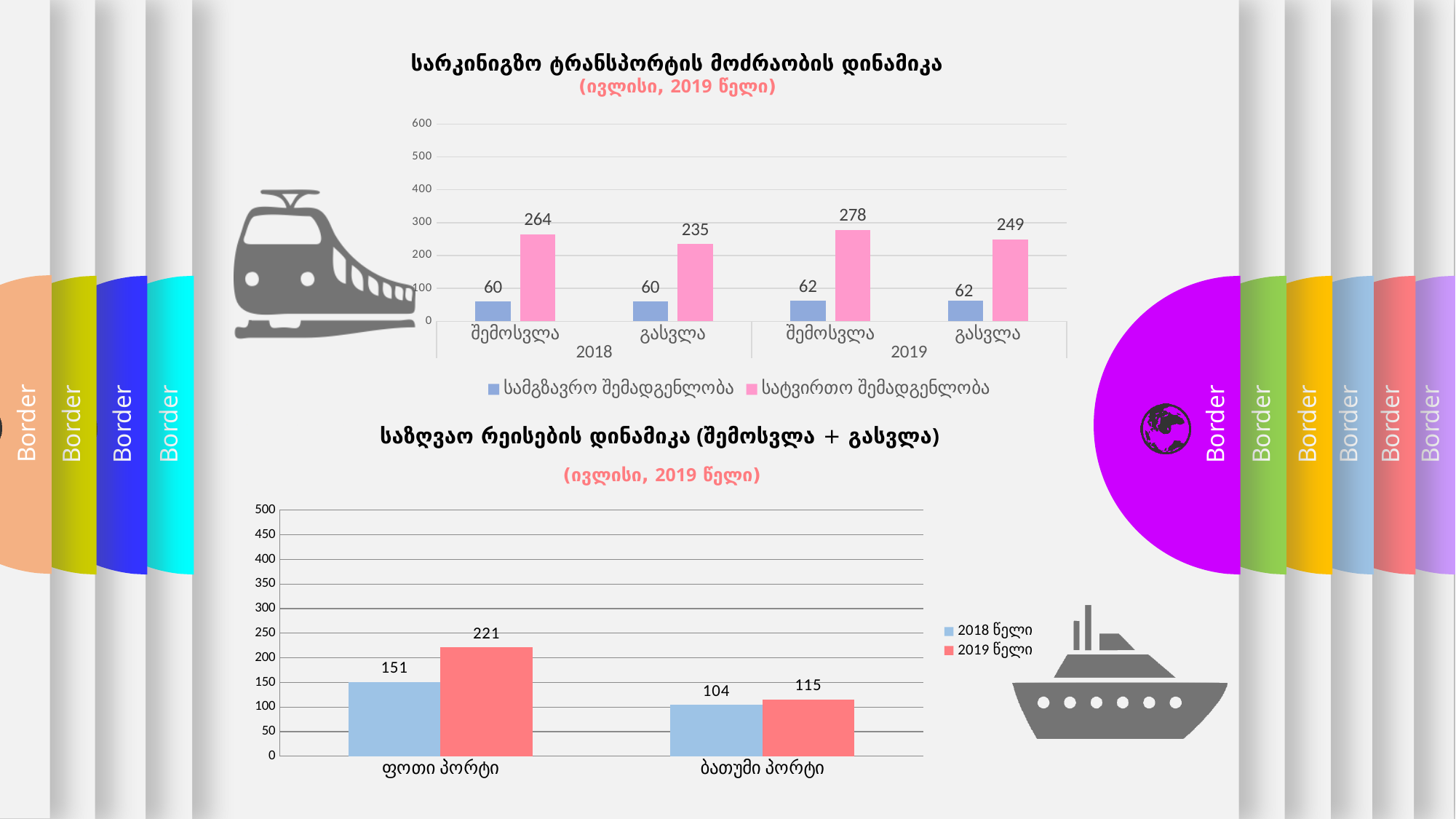
In the top chart (სარკინიგზო ტრანსპორტის მოძრაობის დინამიკა), how many series does the legend list? 2 In the top chart (სარკინიგზო ტრანსპორტის მოძრაობის დინამიკა), what is the value of სამგზავრო შემადგენლობა for გასვლა in 2018? 60 In the top chart (სარკინიგზო ტრანსპორტის მოძრაობის დინამიკა), what is the value of სატვირთო შემადგენლობა for შემოსვლა in 2019? 278 In the top chart (სარკინიგზო ტრანსპორტის მოძრაობის დინამიკა), what is the difference between the სატვირთო შემადგენლობა values for შემოსვლა and გასვლა in 2018? 29 What type of chart is the bottom chart (საზღვაო რეისების დინამიკა)? bar chart In the top chart (სარკინიგზო ტრანსპორტის მოძრაობის დინამიკა), which category has the highest სატვირთო შემადგენლობა value? შემოსვლა 2019 In the bottom chart (საზღვაო რეისების დინამიკა), which is larger: the 2019 წელი value for ბათუმი პორტი or the 2018 წელი value for ფოთი პორტი? 2018 წელი value for ფოთი პორტი In the bottom chart (საზღვაო რეისების დინამიკა), how many port categories are shown on the x axis? 2 In the bottom chart (საზღვაო რეისების დინამიკა), what is the value for ფოთი პორტი in 2019 წელი? 221 In the bottom chart (საზღვაო რეისების დინამიკა), what is the difference between the 2019 წელი and 2018 წელი values for ფოთი პორტი? 70 In the bottom chart (საზღვაო რეისების დინამიკა), what is the value for ბათუმი პორტი in 2018 წელი? 104 In the top chart (სარკინიგზო ტრანსპორტის მოძრაობის დინამიკა), is the სატვირთო შემადგენლობა value for გასვლა in 2019 greater or less than 200? greater